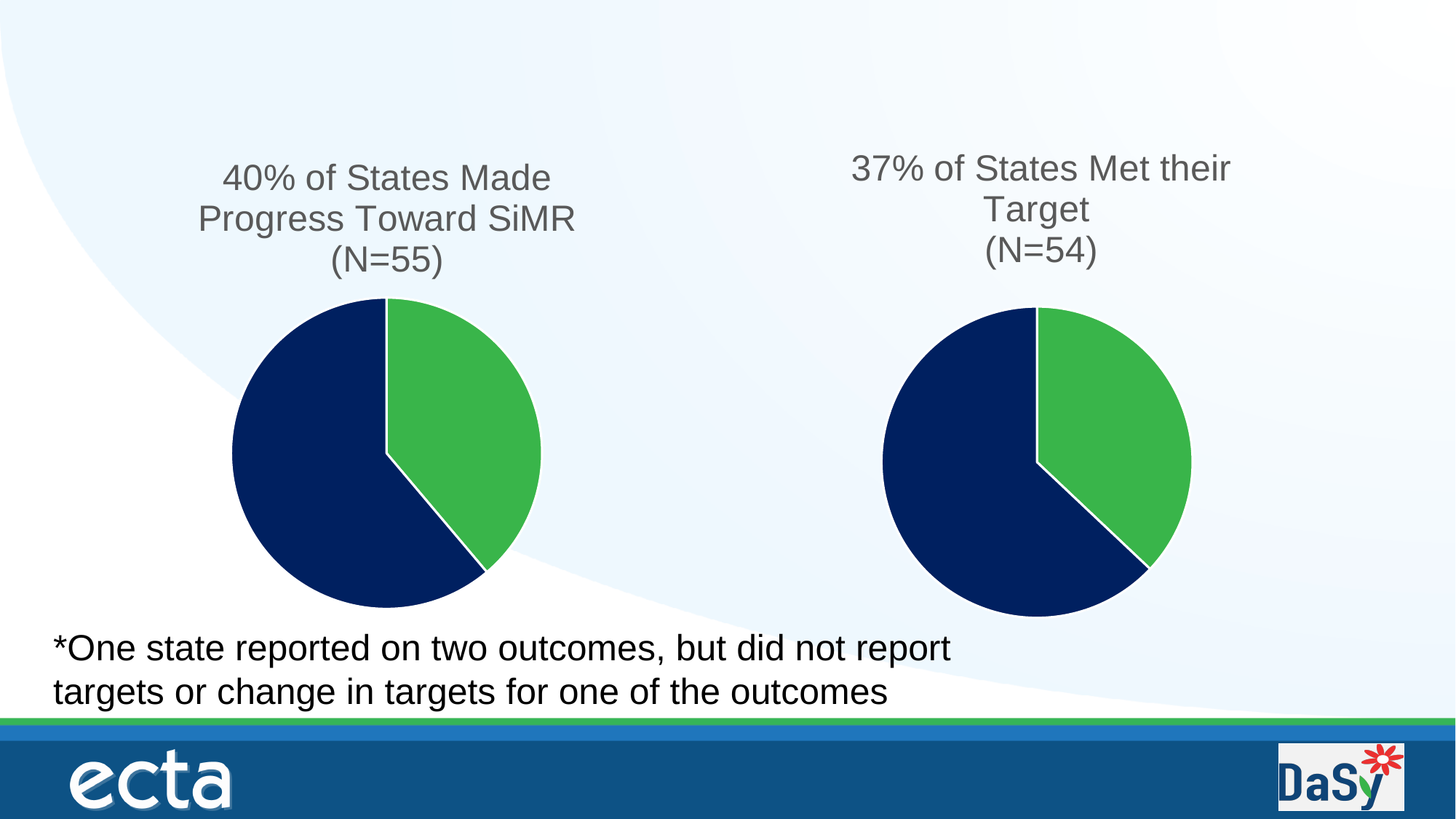
What is the N value shown in the title of the right pie chart? N=54 What kind of chart is the right chart titled "37% of States Met their Target"? pie chart In the left pie chart (Made Progress Toward SiMR), which slice is larger, the green one or the dark blue one? the dark blue one How many slices does the left pie chart (Made Progress Toward SiMR) have? 2 What is the difference in percentage points between the share of states that made progress toward SiMR (left chart) and the share that met their target (right chart)? 3 percentage points In the right pie chart, what share of states met their target? 37% What kind of chart is the left chart titled "40% of States Made Progress Toward SiMR"? pie chart How many slices does the right pie chart (Met their Target) have? 2 In the right pie chart (Met their Target), which slice is larger, the green one or the dark blue one? the dark blue one In the left pie chart, what share of states made progress toward their SiMR? 40% Which is larger: the percentage of states that made progress toward SiMR (left chart) or the percentage that met their target (right chart)? made progress toward SiMR (40%) What is the N value shown in the title of the left pie chart? N=55